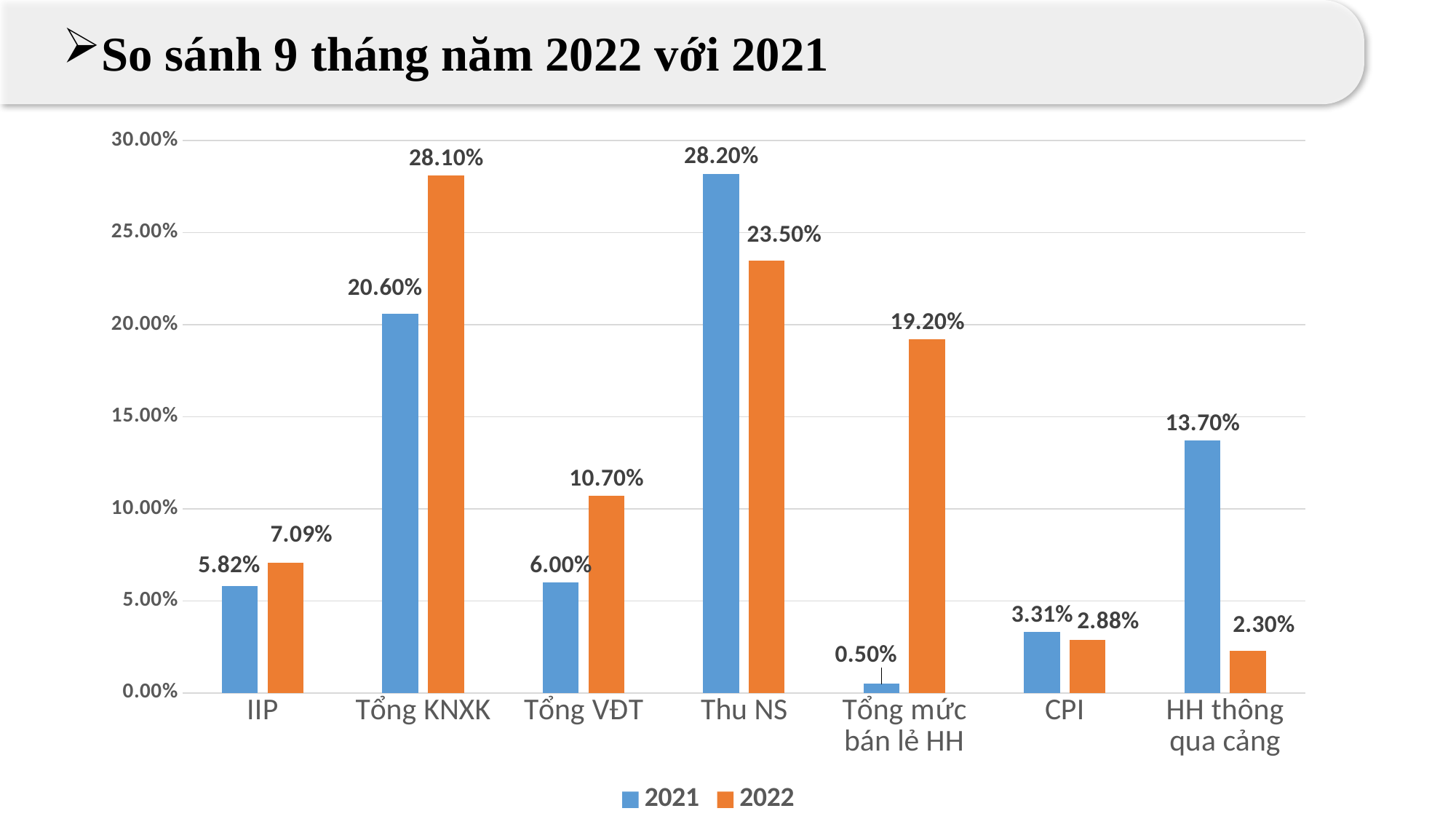
What is the 2022 value for HH thông qua cảng? 2.30% Which category has the highest 2022 value? Tổng KNXK What kind of chart is shown on the slide? Bar chart What is the 2021 value for Thu NS? 28.20% What is the difference between the 2022 and 2021 values for Tổng VĐT? 4.70% How many categories are shown on the x axis? 7 What is the 2021 value for Tổng mức bán lẻ HH? 0.50% How many series does the legend list? 2 What is the 2022 value for Tổng KNXK? 28.10% Which colour represents the 2022 series? Orange Which is larger for CPI, the 2021 value or the 2022 value? 2021 Which category has the lowest 2021 value? Tổng mức bán lẻ HH